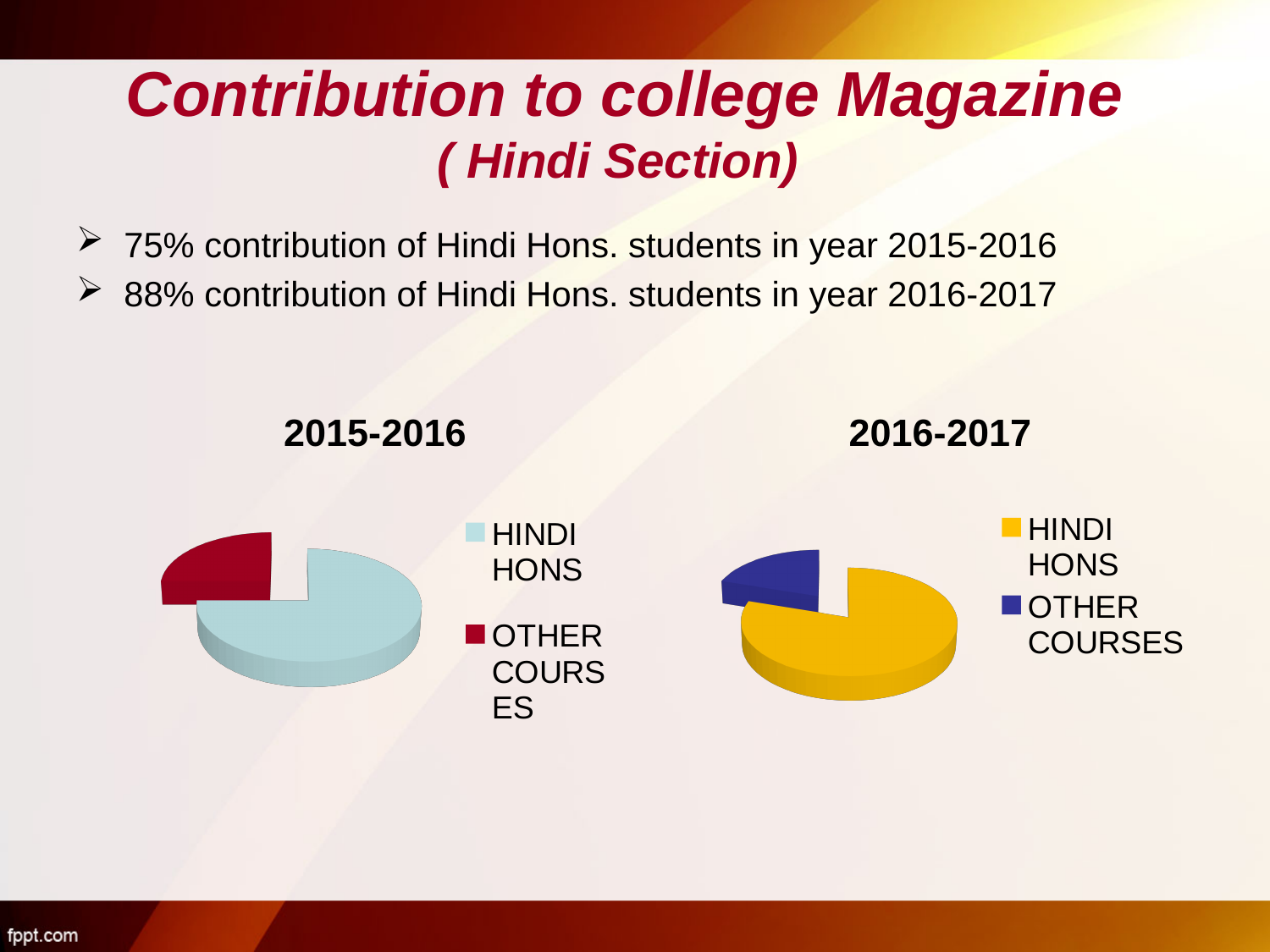
What kind of chart is the 2016-2017 chart? pie chart In the 2015-2016 chart, which category has the smallest slice? OTHER COURSES In the 2016-2017 chart, which category has the smallest slice? OTHER COURSES In the 2016-2017 chart, which slice is larger, HINDI HONS or OTHER COURSES? HINDI HONS In the 2016-2017 chart, what colour is the HINDI HONS slice? yellow What kind of chart is the 2015-2016 chart? pie chart How many slices does the 2015-2016 pie chart have? 2 How many entries does the legend of the 2016-2017 chart list? 2 What is the title of the chart on the left of the slide? 2015-2016 In the 2015-2016 chart, which category has the largest slice? HINDI HONS In the 2016-2017 chart, which category has the largest slice? HINDI HONS